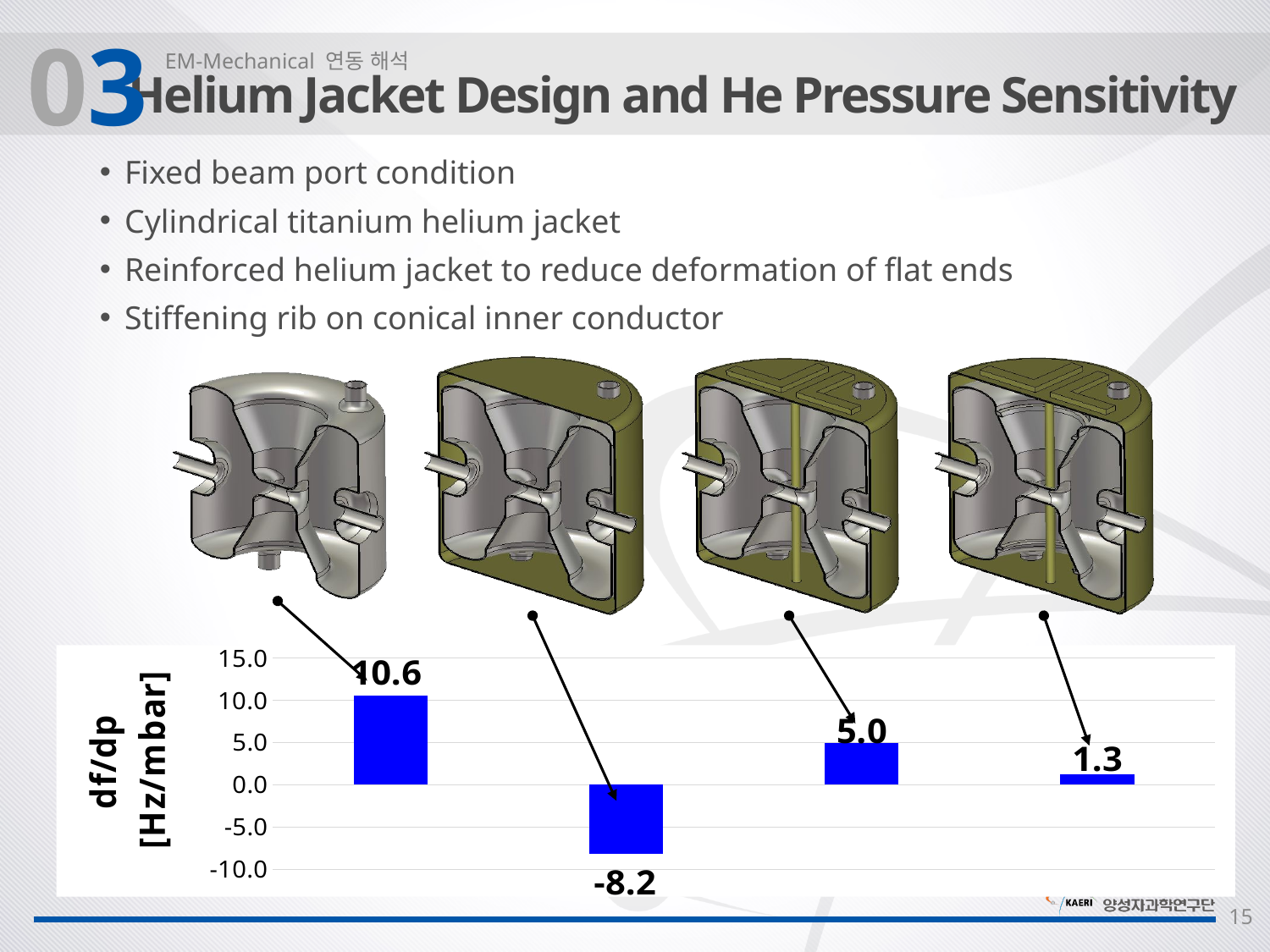
What is the difference between the first bar (10.6) and the third bar (5.0)? 5.6 Which bar has the highest value in the chart? the first (leftmost) bar, 10.6 What is the value of the third bar from the left in the chart? 5.0 What is the label on the vertical axis of the chart? df/dp [Hz/mbar] Which is larger, the value of the third bar or the value of the fourth bar? the third bar (5.0) What is the value of the first (leftmost) bar in the chart? 10.6 What type of chart is shown at the bottom of the slide? bar chart What is the value of the second bar from the left in the chart? -8.2 What is the value of the fourth (rightmost) bar in the chart? 1.3 Which bar has the lowest value in the chart? the second bar from the left, -8.2 Is the value of the first bar greater or less than 10.0? greater How many bars are plotted in the chart? 4